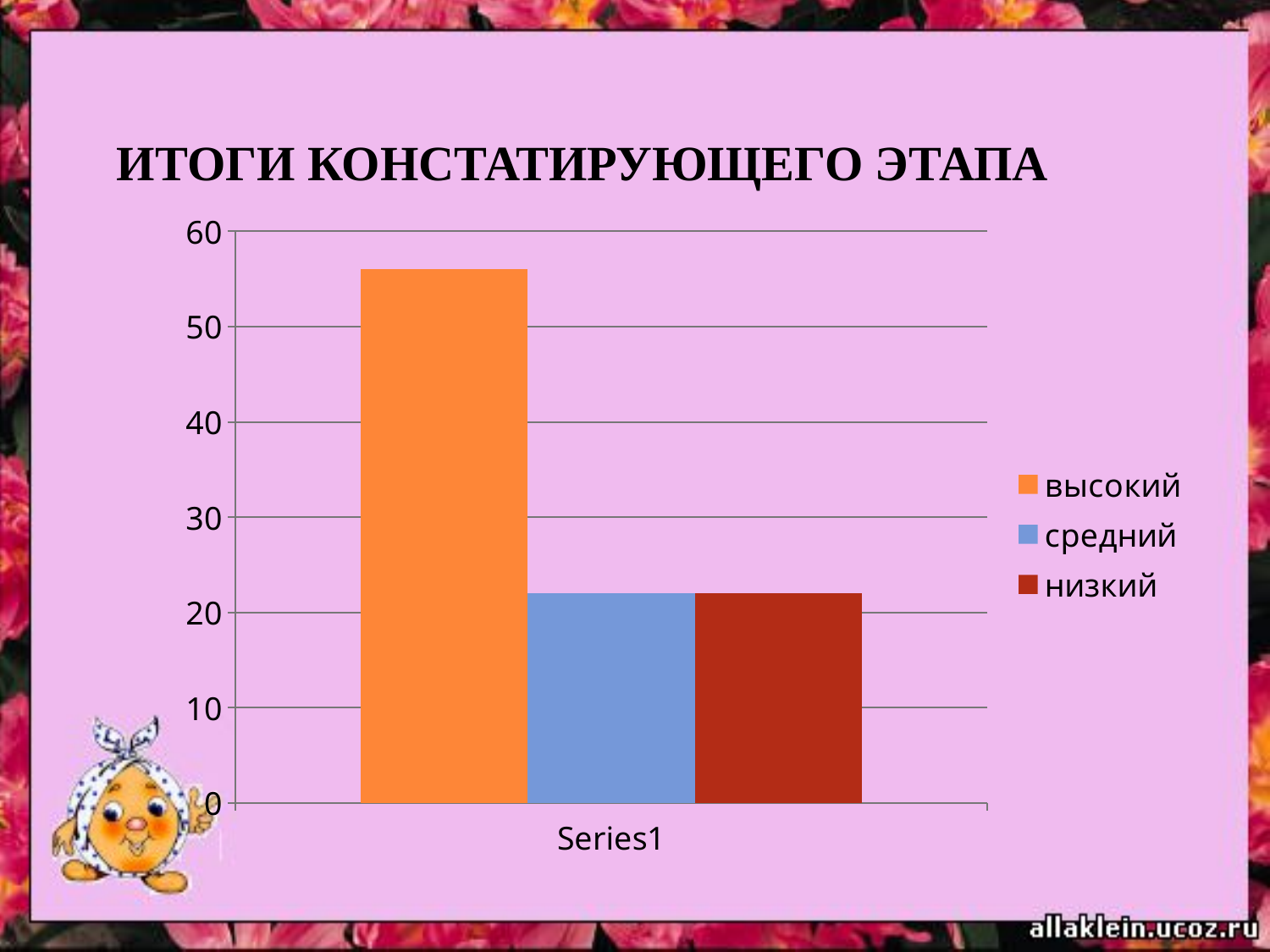
What is the title of the chart? ИТОГИ КОНСТАТИРУЮЩЕГО ЭТАПА What kind of chart is shown on the slide? bar chart Is the value for высокий greater or less than 60? less Which is larger, the value for низкий or the value for высокий? высокий How many bars are plotted in the chart? 3 Is the value for низкий greater or less than 20? greater How many entries does the legend list? 3 Is the value for высокий greater or less than 50? greater Which is larger, the value for высокий or the value for средний? высокий Which legend entry has the tallest bar? высокий What label is shown on the horizontal axis under the bars? Series1